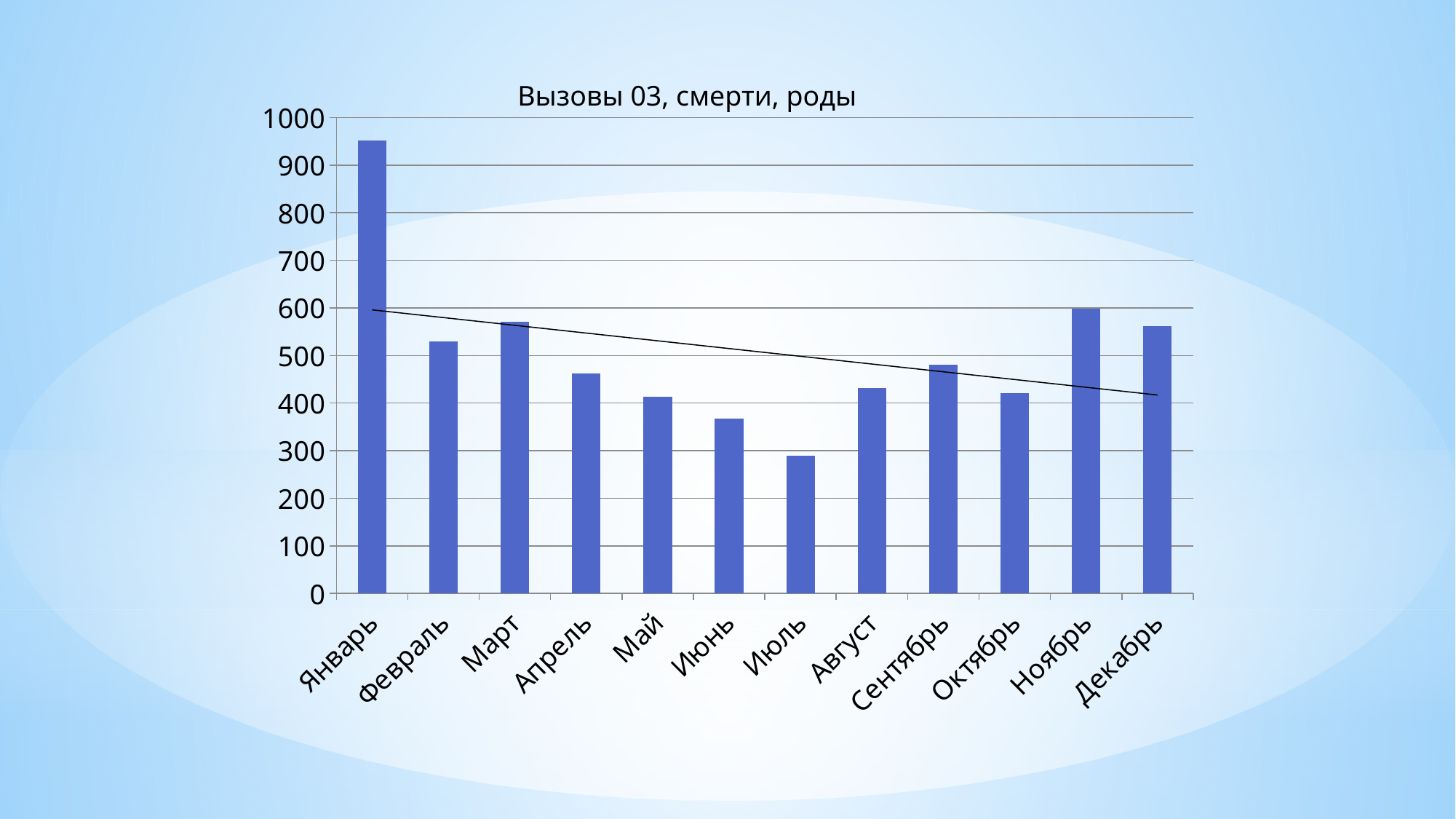
Which is larger, the value for Сентябрь or the value for Октябрь? Сентябрь What kind of chart is shown on the slide? bar chart Is the value for Январь greater or less than 900? greater Which is larger, the value for Март or the value for Апрель? Март Is the value for Июль greater or less than 300? less How many months (categories) are shown on the x axis? 12 What is the title of the chart? Вызовы 03, смерти, роды Which month has the highest value? Январь Is the value for Июнь greater or less than 400? less Which month has the lowest value? Июль Does the trend line drawn across the chart rise or fall from left to right? fall